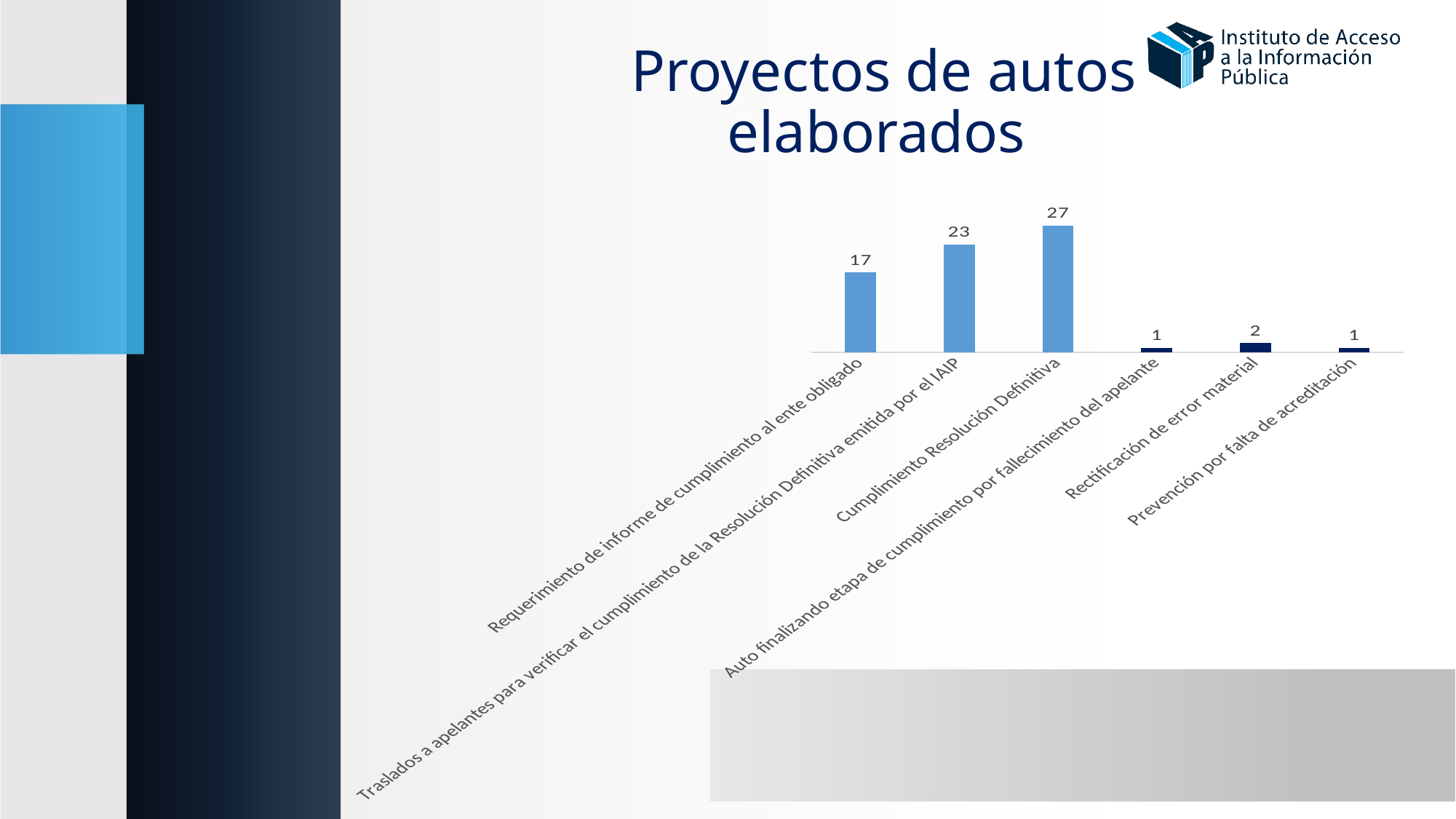
What is the value for Requerimiento de informe de cumplimiento al ente obligado? 17 What is the value for Cumplimiento Resolución Definitiva? 27 What is the value for Auto finalizando etapa de cumplimiento por fallecimiento del apelante? 1 What is the value for Traslados a apelantes para verificar el cumplimiento de la Resolución Definitiva emitida por el IAIP? 23 How many categories are shown in the chart? 6 What kind of chart is shown on the slide? Bar chart What is the difference between the values for Rectificación de error material and Prevención por falta de acreditación? 1 What is the difference between the values for Cumplimiento Resolución Definitiva and Requerimiento de informe de cumplimiento al ente obligado? 10 Which category has the highest value? Cumplimiento Resolución Definitiva What is the title of the slide? Proyectos de autos elaborados What is the value for Rectificación de error material? 2 Which is larger: the value for Traslados a apelantes para verificar el cumplimiento de la Resolución Definitiva emitida por el IAIP or the value for Requerimiento de informe de cumplimiento al ente obligado? Traslados a apelantes para verificar el cumplimiento de la Resolución Definitiva emitida por el IAIP